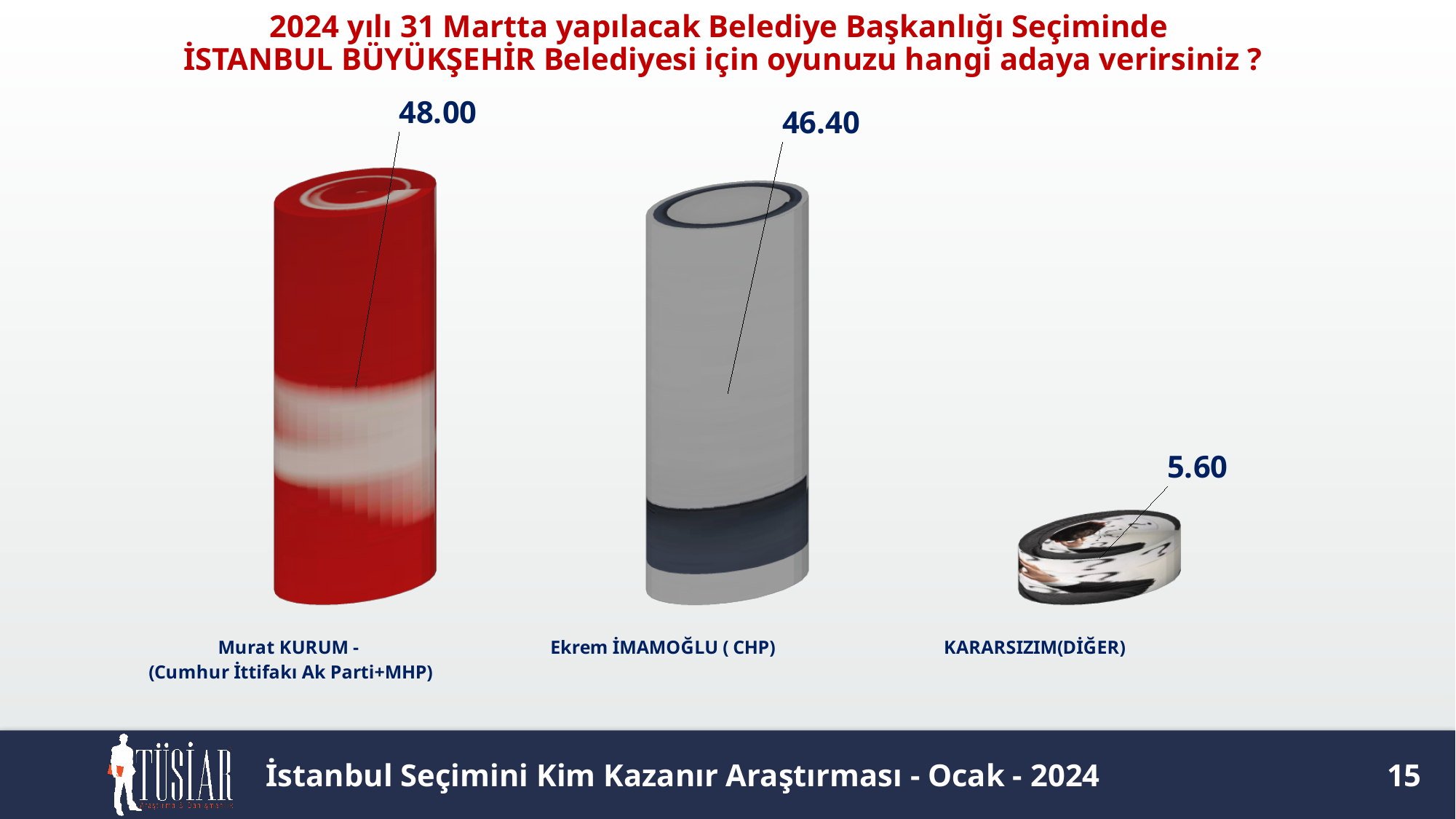
What kind of chart is shown on the slide? Bar chart Which is larger, the value for Murat KURUM or the value for Ekrem İMAMOĞLU? Murat KURUM What is the value for Ekrem İMAMOĞLU ( CHP)? 46.40 What is the title of the chart? 2024 yılı 31 Martta yapılacak Belediye Başkanlığı Seçiminde İSTANBUL BÜYÜKŞEHİR Belediyesi için oyunuzu hangi adaya verirsiniz ? What colour is the bar for Murat KURUM? Red Which category has the highest value? Murat KURUM - (Cumhur İttifakı Ak Parti+MHP) What is the difference between the values for Ekrem İMAMOĞLU and KARARSIZIM(DİĞER)? 40.80 Which category has the lowest value? KARARSIZIM(DİĞER) What is the difference between the values for Murat KURUM and Ekrem İMAMOĞLU? 1.60 What is the value for Murat KURUM - (Cumhur İttifakı Ak Parti+MHP)? 48.00 What is the value for KARARSIZIM(DİĞER)? 5.60 How many categories are shown in the chart? 3